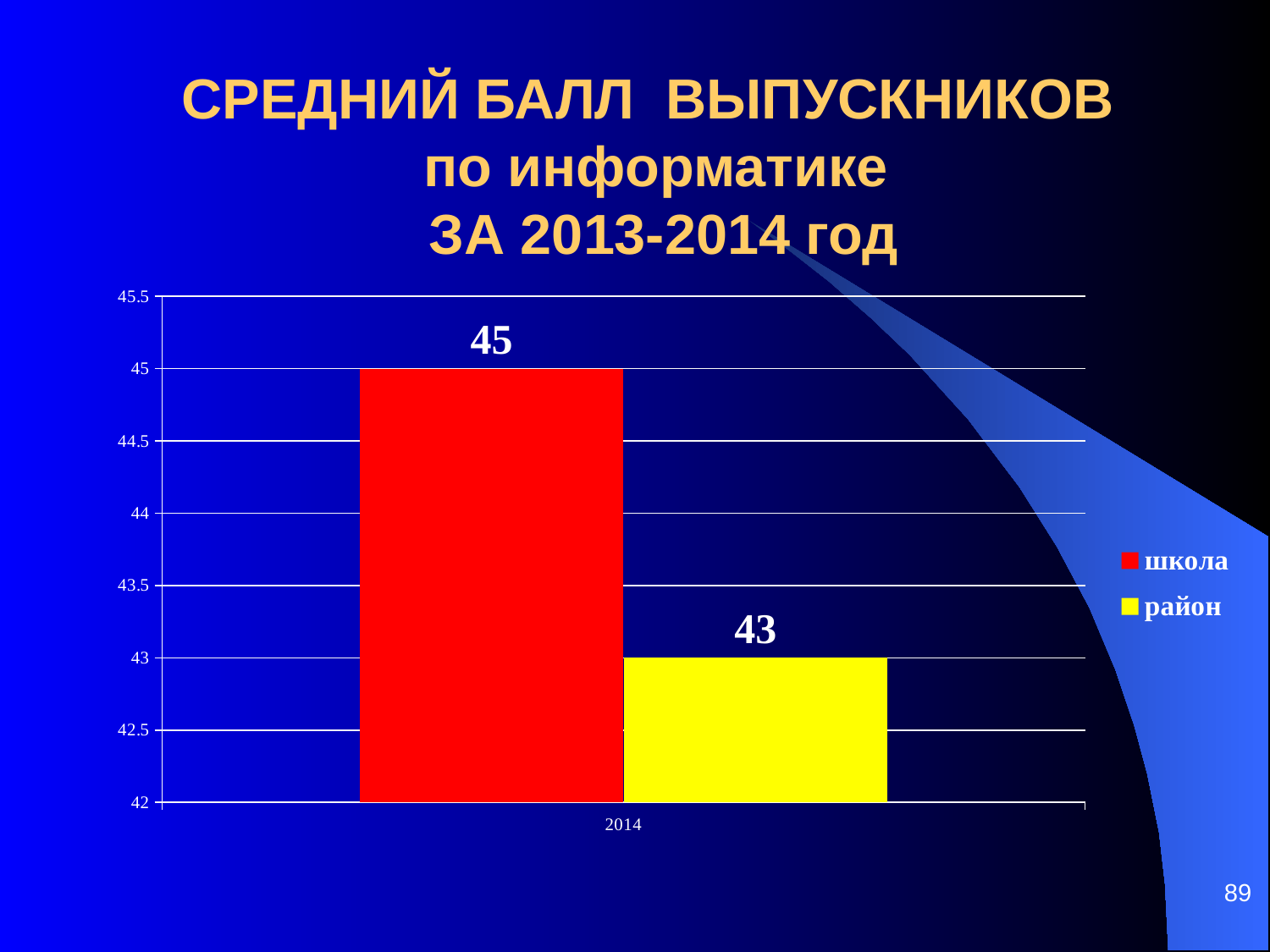
Is the value for район greater or less than 44? less How many categories are shown on the x axis? 1 Which series has the higher value, школа or район? школа What is the difference between the школа and район values? 2 Which series has the lowest value on the chart? район How many series does the legend list? 2 What colour is the bar for школа? red What category label is shown on the x axis? 2014 Is the value for школа greater or less than 44.5? greater What is the value for район in 2014? 43 What is the value for школа in 2014? 45 What kind of chart is shown on the slide? bar chart